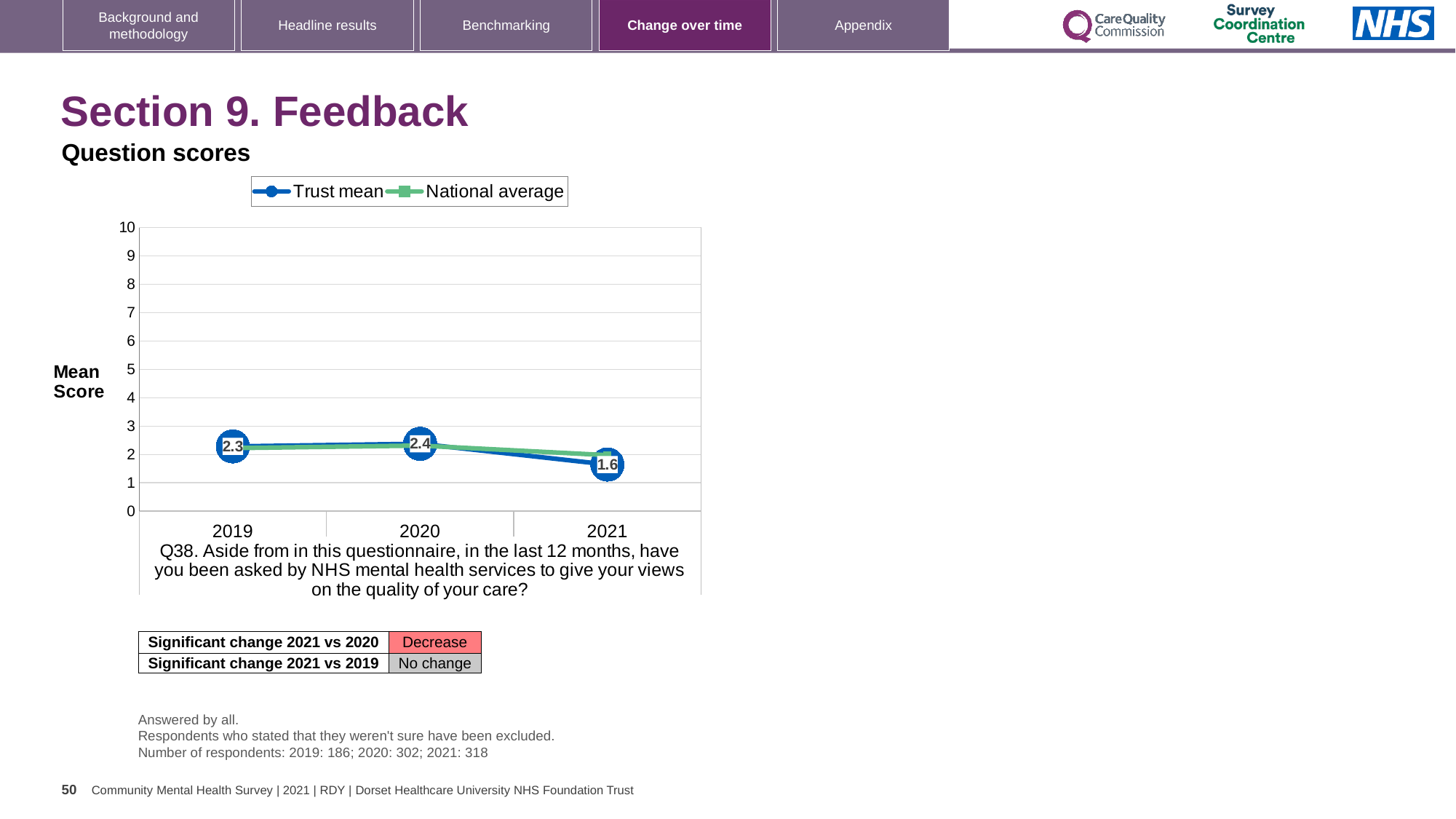
Is the National average value for 2021 greater or less than 3? less What is the Trust mean score for 2019? 2.3 What is the difference between the Trust mean scores for 2020 and 2021? 0.8 How many series does the legend list? 2 In which year is the Trust mean score highest? 2020 Which is larger in 2021, the Trust mean or the National average? National average What kind of chart is shown on the slide? Line chart Does the Trust mean rise or fall from 2020 to 2021? Fall In which year is the Trust mean score lowest? 2021 What is the Trust mean score for 2021? 1.6 How many years are plotted on the x axis? 3 What is the Trust mean score for 2020? 2.4